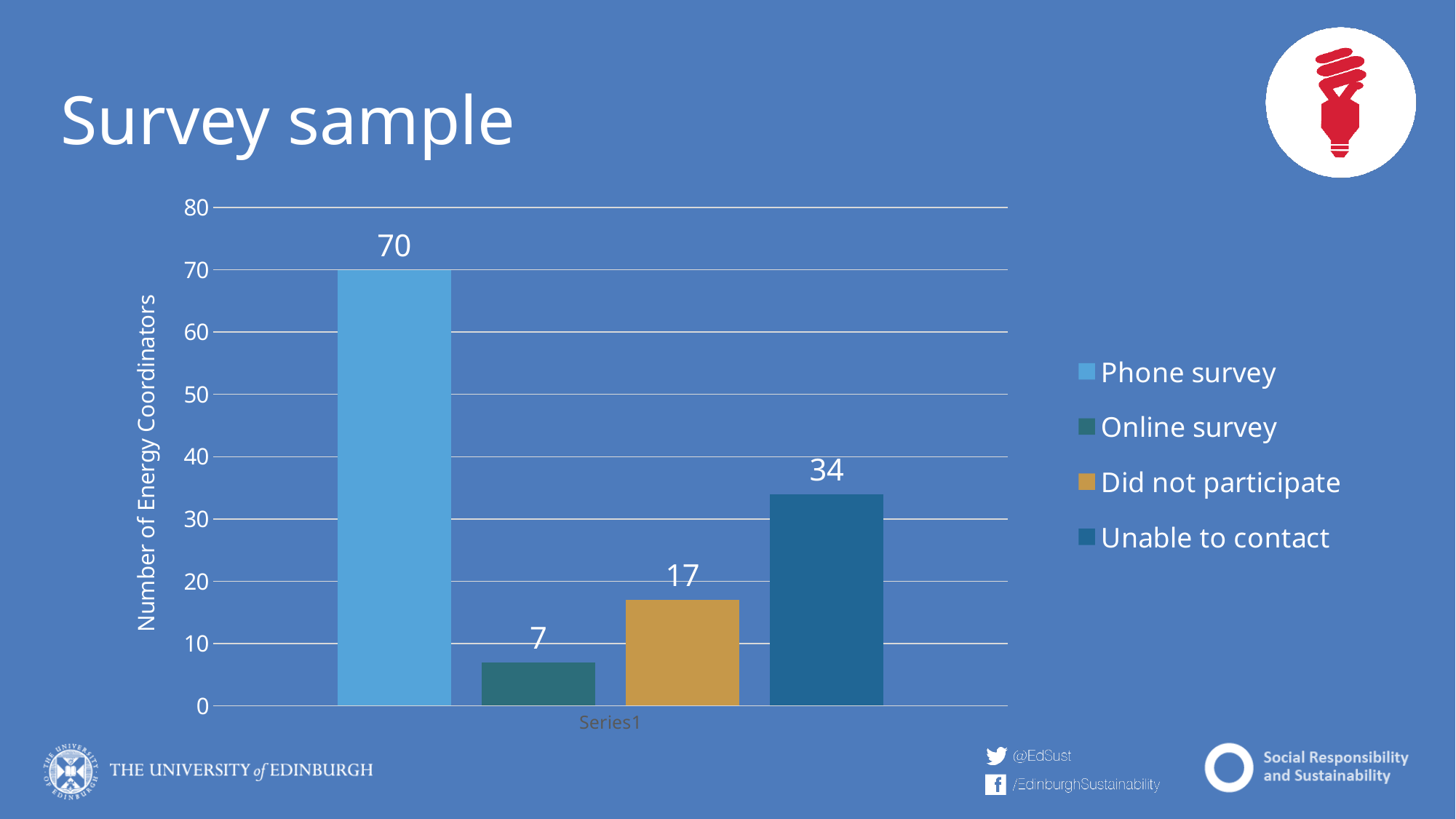
Which series has the highest value? Phone survey How many series does the legend list? 4 What is the label of the vertical axis? Number of Energy Coordinators Is the value for Did not participate greater or less than 20? less What is the value for Online survey? 7 What is the value for Unable to contact? 34 What kind of chart is shown on the slide? bar chart Which is larger, Did not participate or Unable to contact? Unable to contact Which series has the lowest value? Online survey What is the value for Did not participate? 17 What is the difference between the Phone survey and Unable to contact values? 36 What is the value for Phone survey? 70